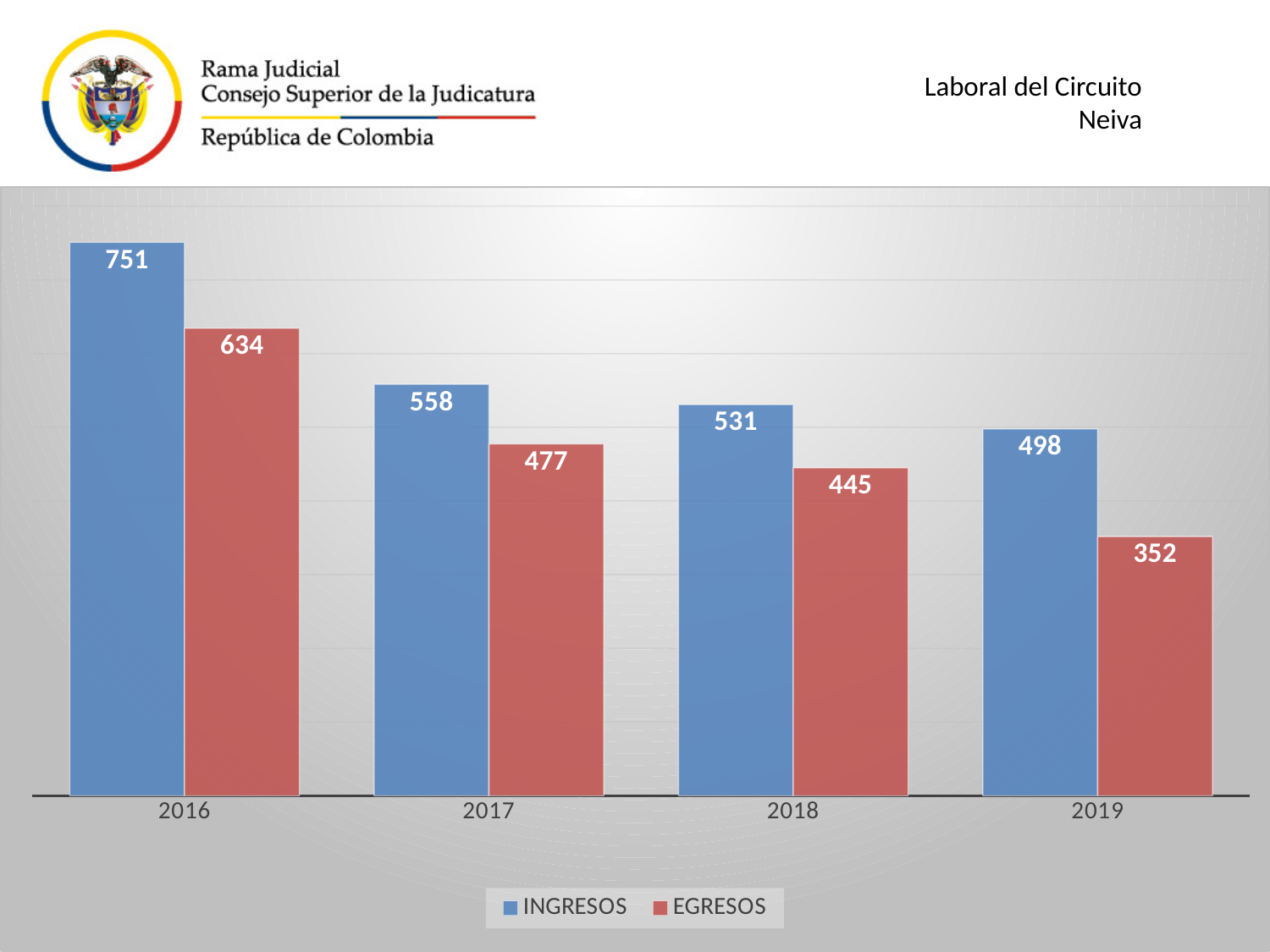
What is the difference between INGRESOS in 2016 and INGRESOS in 2019? 253 Which is larger, EGRESOS in 2016 or INGRESOS in 2017? EGRESOS in 2016 What is the EGRESOS value for 2017? 477 What is the difference between INGRESOS and EGRESOS in 2018? 86 Do the INGRESOS values rise or fall from 2016 to 2019? Fall What is the INGRESOS value for 2016? 751 How many years are shown on the x axis? 4 How many series does the legend list? 2 What kind of chart is shown on the slide? Bar chart Which year has the highest INGRESOS value? 2016 Which year has the lowest EGRESOS value? 2019 What is the EGRESOS value for 2019? 352